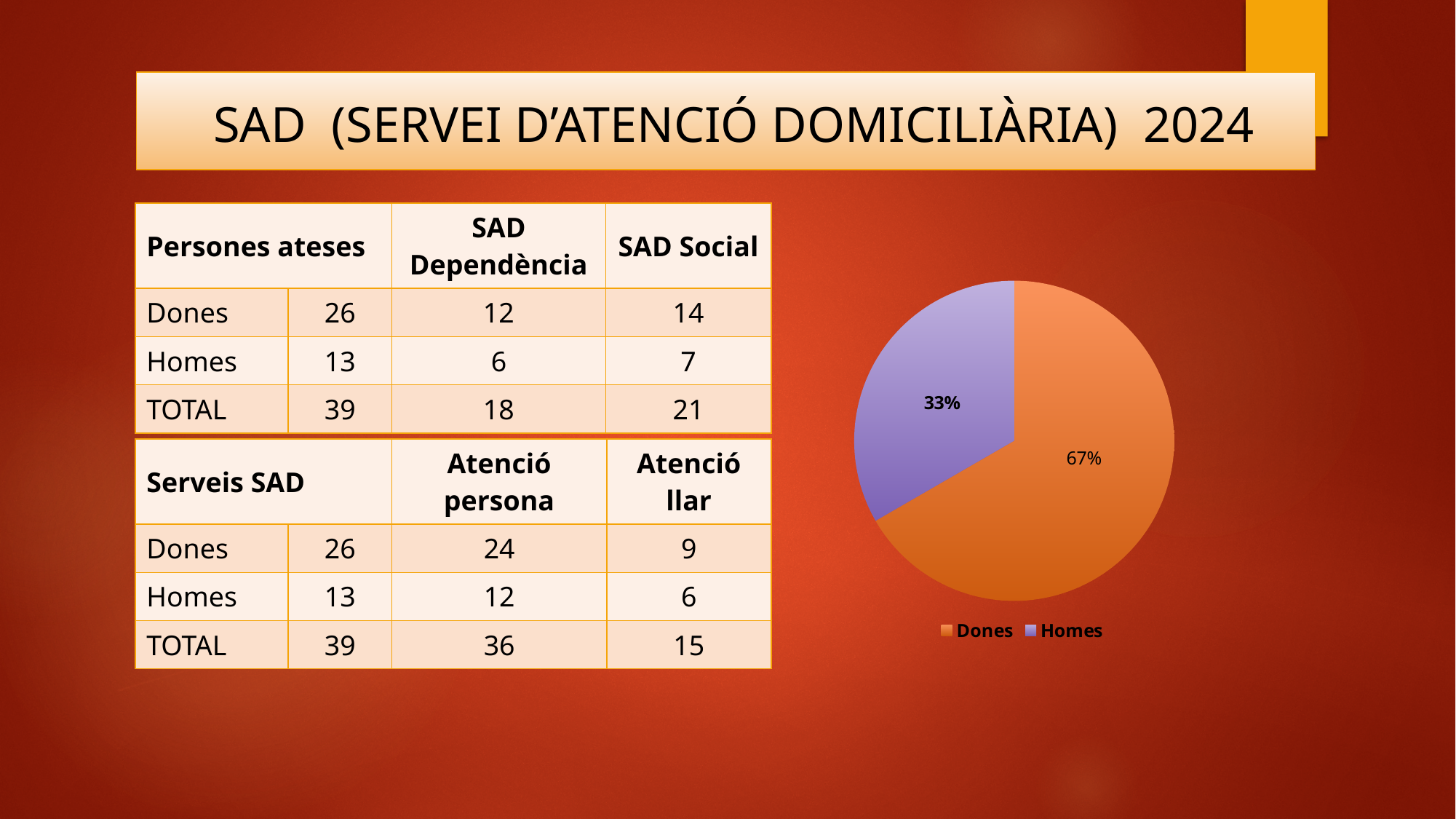
What kind of chart is shown on the slide? pie chart What share of the pie chart does Homes represent? 33% Which slice of the pie chart is the smallest? Homes How many entries does the pie chart's legend list? 2 What is the difference in percentage points between the Dones and Homes slices of the pie chart? 34 What are the two legend entries of the pie chart? Dones and Homes What share of the pie chart does Dones represent? 67% How many slices does the pie chart have? 2 In the pie chart, which is larger, Dones or Homes? Dones What colour is the Homes slice in the pie chart? purple Which slice of the pie chart is the largest? Dones